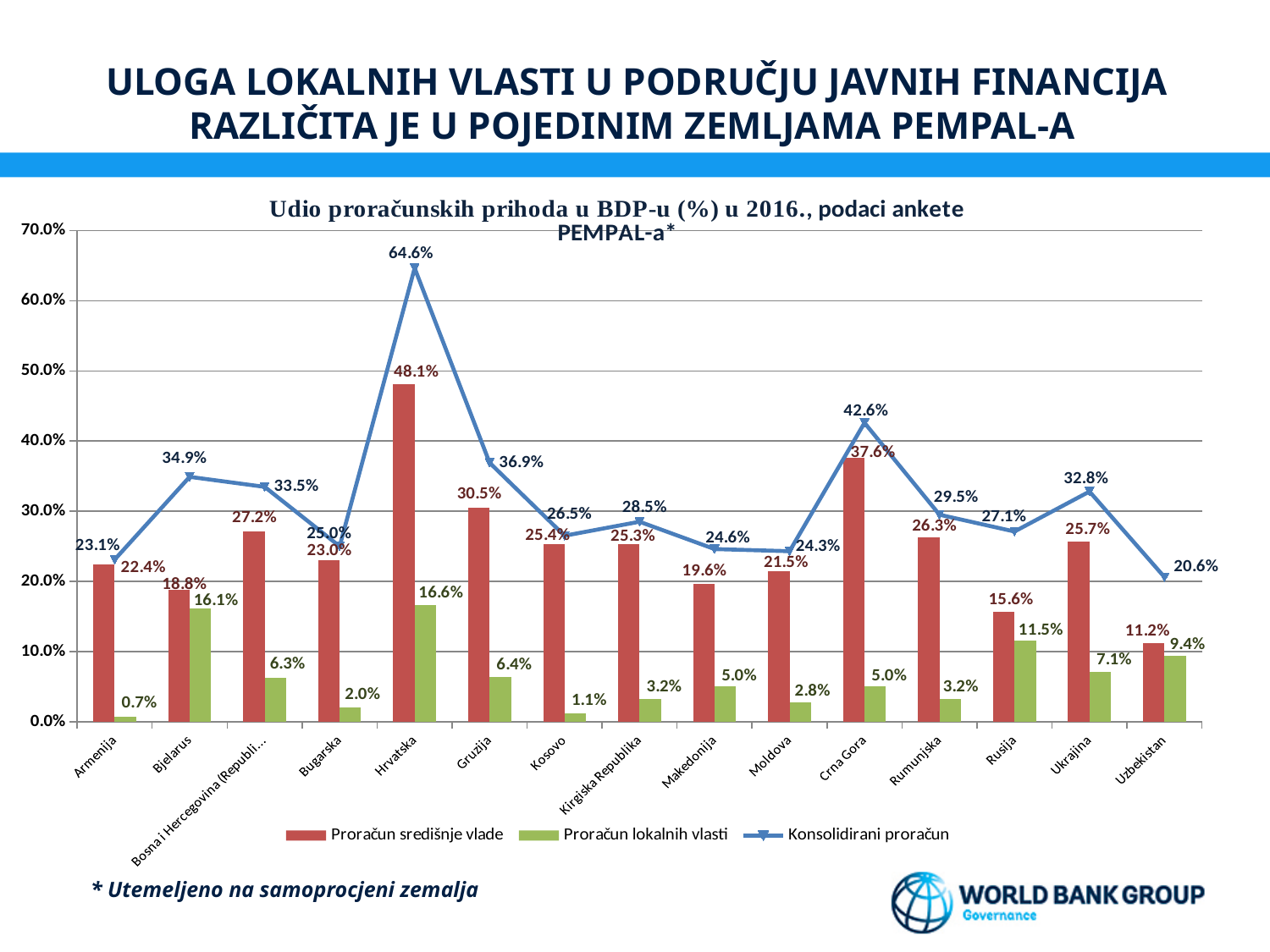
Which country has the highest Konsolidirani proračun value? Hrvatska How many countries are shown on the x axis? 15 Which is larger: the Proračun lokalnih vlasti value for Rusija or for Ukrajina? Rusija What is the value of Proračun središnje vlade for Hrvatska? 48.1% Which country has the lowest Proračun središnje vlade value? Uzbekistan What is the Konsolidirani proračun value for Crna Gora? 42.6% What is the value of Proračun lokalnih vlasti for Bjelarus? 16.1% Which country has the lowest Proračun lokalnih vlasti value? Armenija How many series does the legend list? 3 Which series is shown as a blue line? Konsolidirani proračun What kind of chart is this? Combined bar and line chart What is the difference between the Konsolidirani proračun values for Hrvatska and Crna Gora? 22.0%